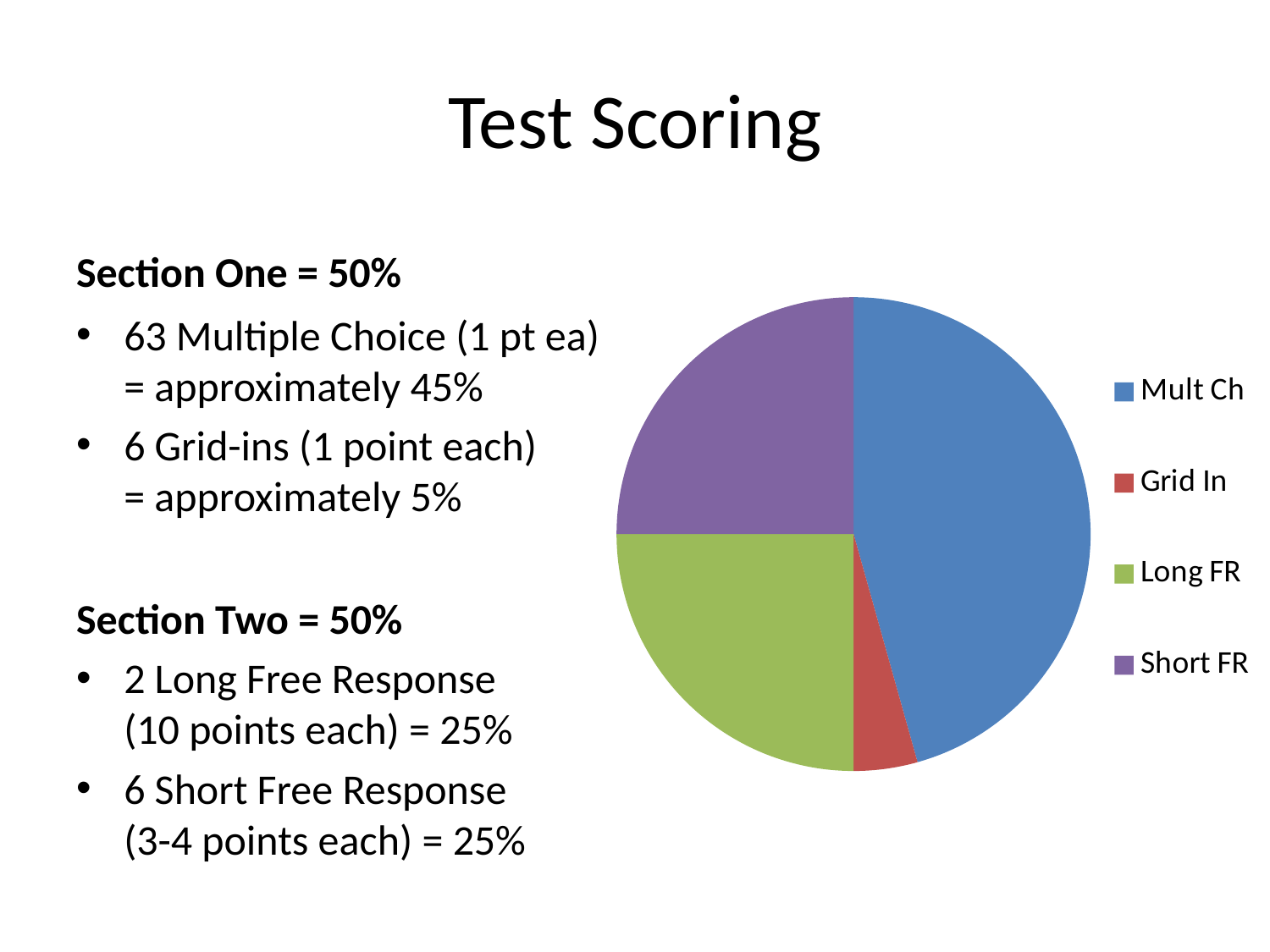
How many slices does the pie chart have? 4 Which slice is larger in the pie chart, Mult Ch or Short FR? Mult Ch What is the title of the slide containing the pie chart? Test Scoring Which slice is larger in the pie chart, Long FR or Grid In? Long FR How many entries does the legend of the pie chart list? 4 Which category has the largest slice in the pie chart? Mult Ch Which category is shown in green in the pie chart? Long FR Which slice is larger in the pie chart, Mult Ch or Grid In? Mult Ch What kind of chart is shown on the slide? Pie chart Which category has the smallest slice in the pie chart? Grid In What colour is the Mult Ch slice in the pie chart? Blue